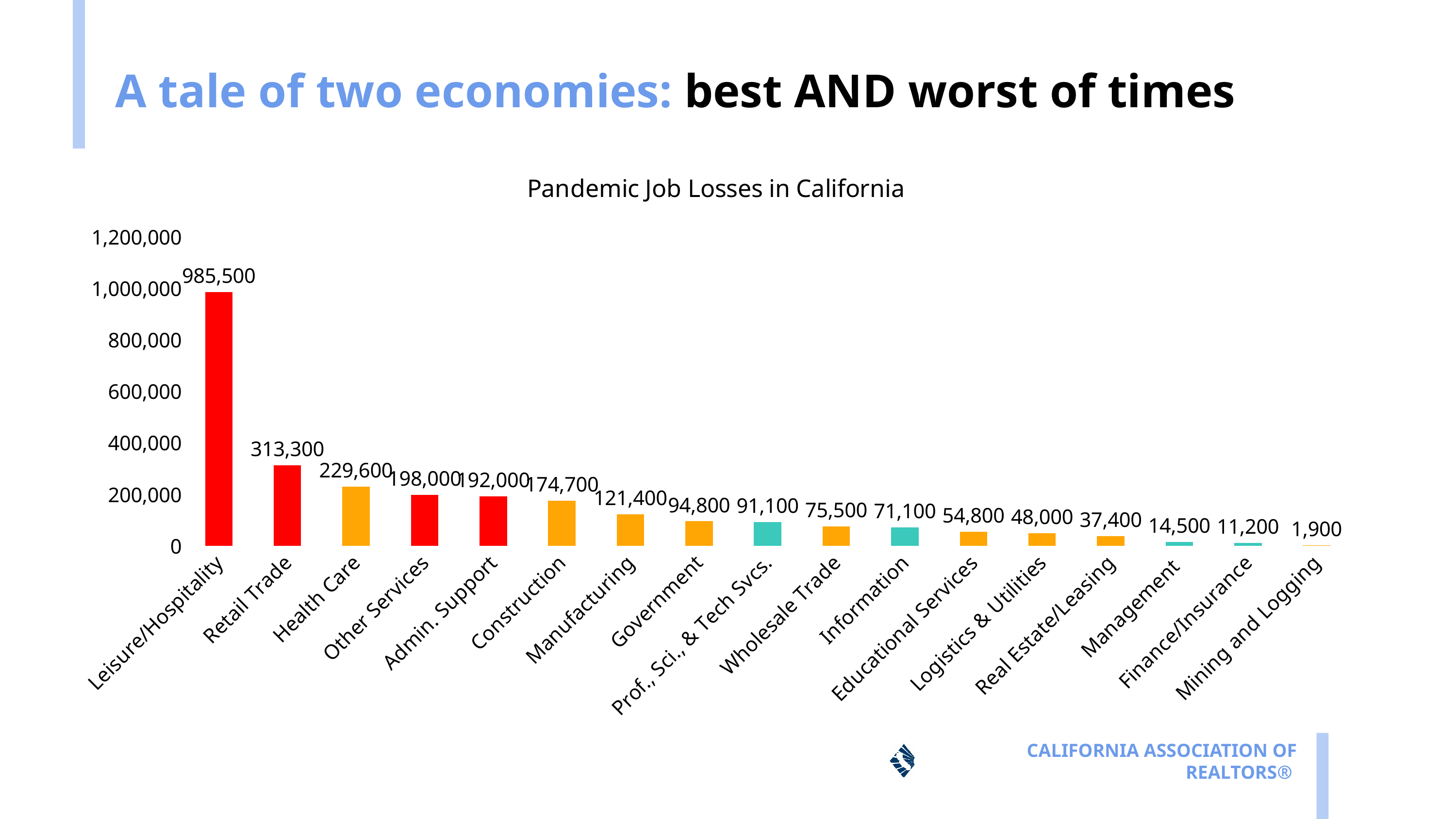
What is the difference between the values for Health Care and Other Services? 31,600 Do the values rise or fall moving from left to right along the x axis? fall Is the value for Retail Trade greater or less than 400,000? less Which category has the lowest job losses? Mining and Logging What is the value for Leisure/Hospitality in the Pandemic Job Losses in California chart? 985,500 What is the value for Real Estate/Leasing? 37,400 How many categories are shown in the chart? 17 What kind of chart is shown on the slide? bar chart What is the value for Construction? 174,700 Which category has the highest job losses? Leisure/Hospitality What is the difference between the values for Leisure/Hospitality and Retail Trade? 672,200 Which is larger, the value for Manufacturing or the value for Government? Manufacturing